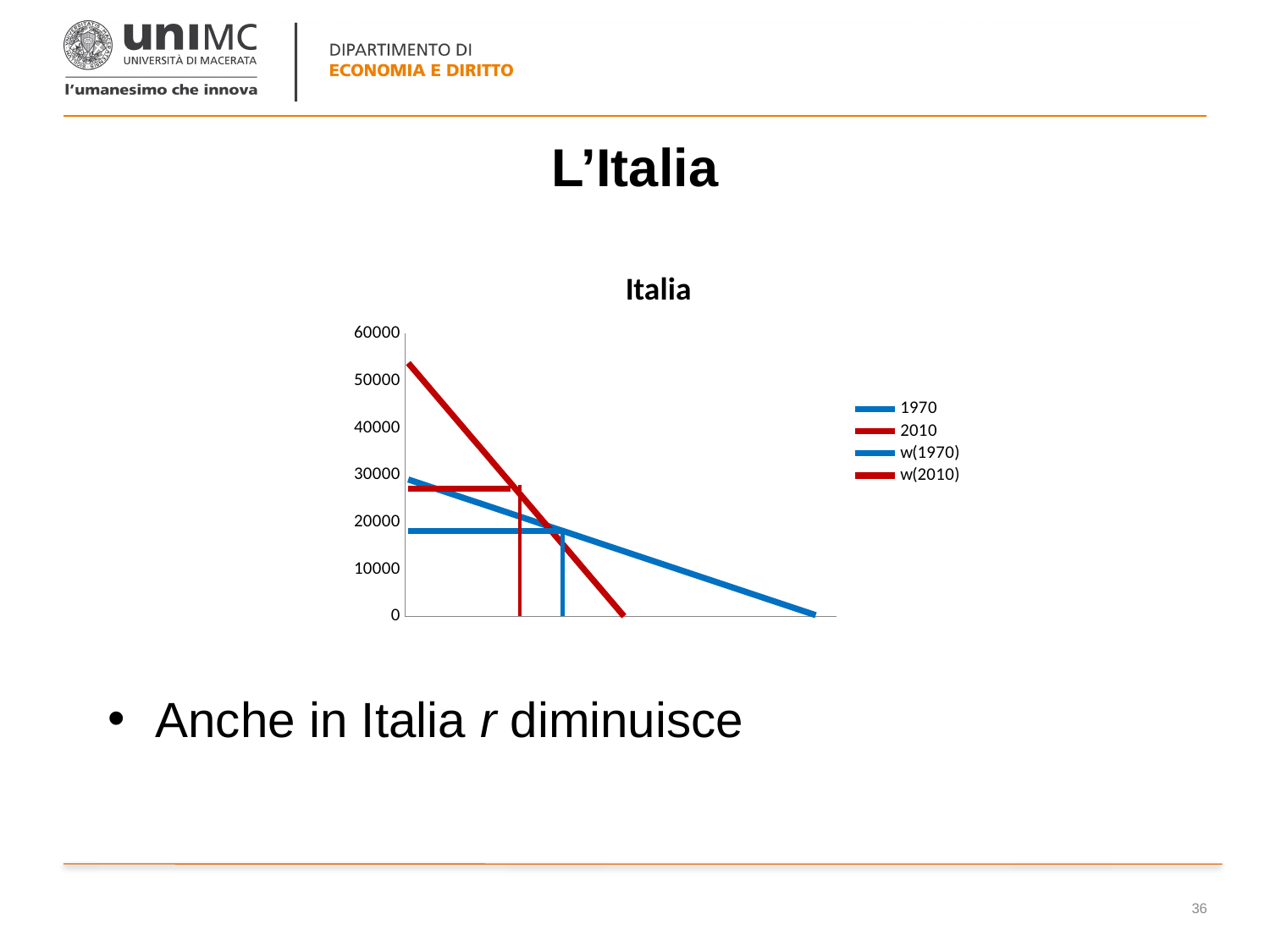
Is the level of the horizontal w(2010) line greater or less than 20000? greater How many series does the legend of the chart list? 4 Which line starts higher at the left edge of the chart, 1970 or 2010? 2010 Is the value of the 2010 line at the left edge of the chart greater or less than 50000? greater Is the level of the horizontal w(1970) line greater or less than 20000? less Which horizontal line sits higher on the chart, w(1970) or w(2010)? w(2010) Does the 2010 line rise or fall moving from left to right along the x axis? fall What is the title of the chart? Italia What type of chart is shown on the slide? line chart Which line reaches zero further to the right along the x axis, 1970 or 2010? 1970 What colour are the 2010 and w(2010) lines in the chart? red